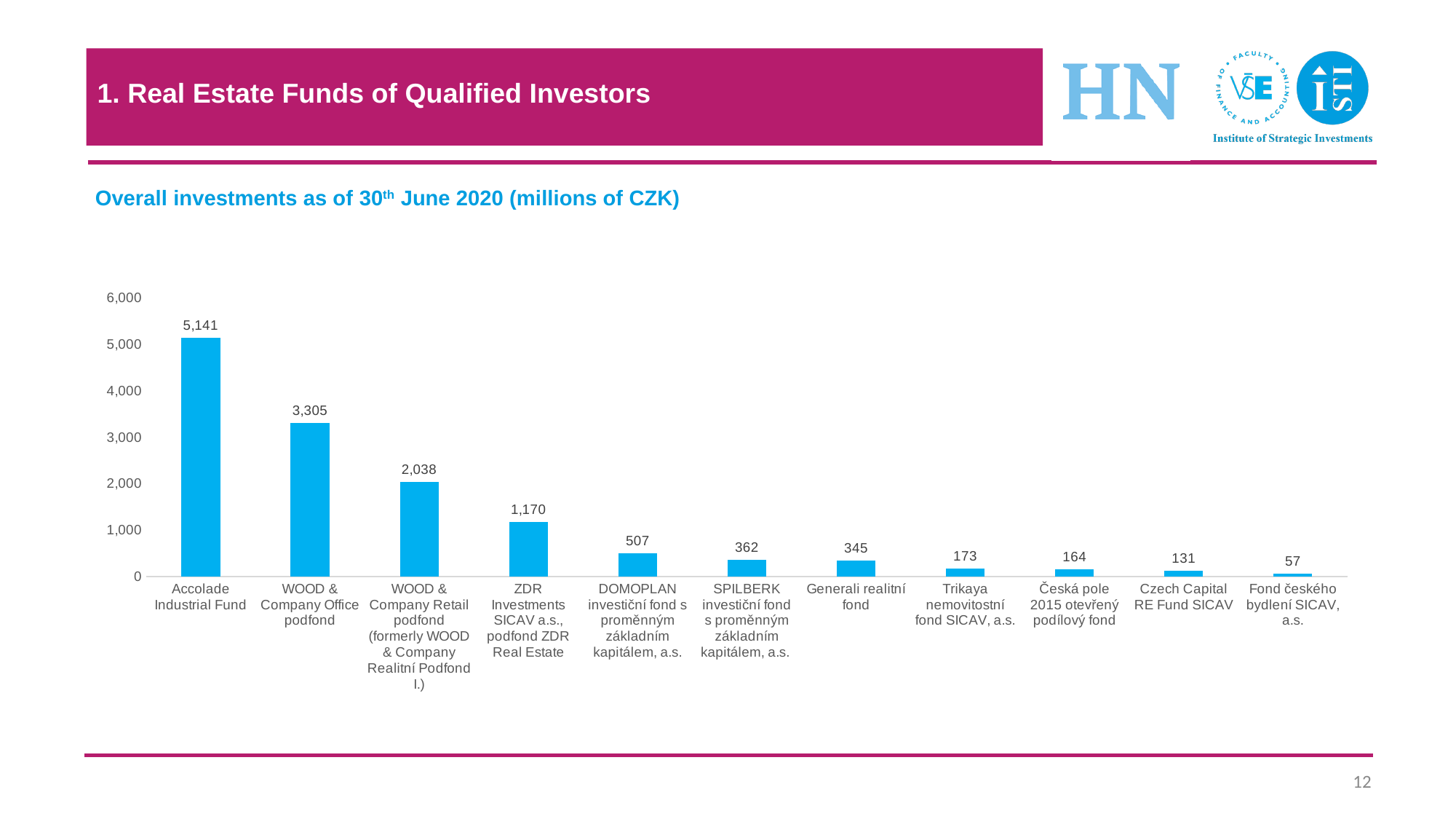
How many funds are shown in the chart? 11 Do the values rise or fall from left to right along the x axis? fall What is the value for ZDR Investments SICAV a.s., podfond ZDR Real Estate? 1,170 What is the value for Accolade Industrial Fund? 5,141 What kind of chart is shown on the slide? bar chart What is the value for Generali realitní fond? 345 Is the value for WOOD & Company Office podfond greater or less than 3,000? greater Which fund has the lowest overall investments? Fond českého bydlení SICAV, a.s. Which fund has the highest overall investments? Accolade Industrial Fund Which is larger, the value for DOMOPLAN investiční fond s proměnným základním kapitálem, a.s. or SPILBERK investiční fond s proměnným základním kapitálem, a.s.? DOMOPLAN investiční fond s proměnným základním kapitálem, a.s. What is the title of the chart? Overall investments as of 30th June 2020 (millions of CZK) What is the difference between the values for WOOD & Company Office podfond and WOOD & Company Retail podfond? 1,267